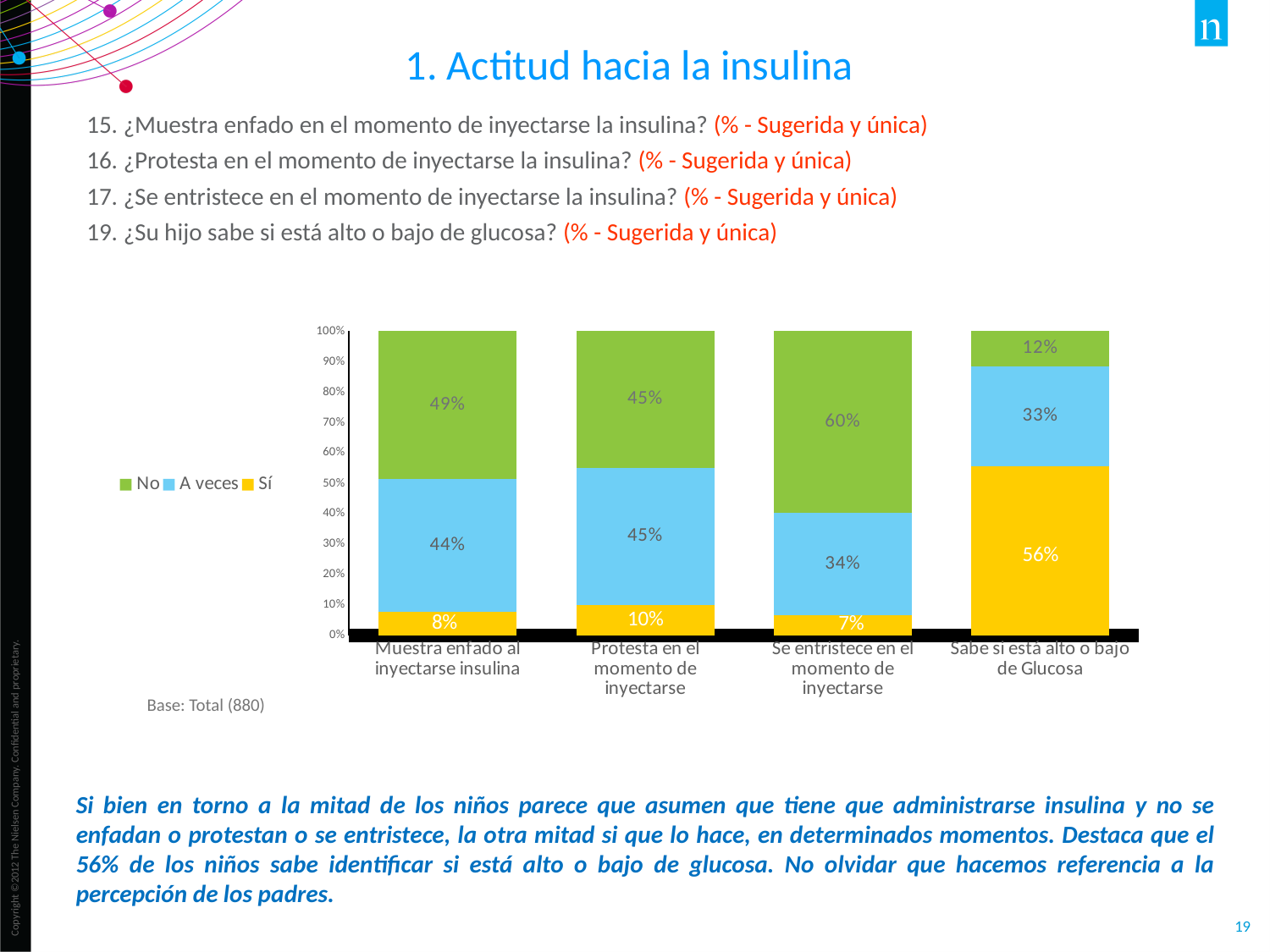
Which is larger: the "A veces" value for "Protesta en el momento de inyectarse" or the "A veces" value for "Se entristece en el momento de inyectarse"? Protesta en el momento de inyectarse What is the value of "Sí" for "Protesta en el momento de inyectarse"? 10% What is the value of "No" for "Se entristece en el momento de inyectarse"? 60% How many categories are shown on the x axis of the chart? 4 Which category has the lowest value for "No"? Sabe si está alto o bajo de Glucosa What kind of chart is shown on the slide? Stacked bar chart Which series is shown in yellow in the chart legend? Sí How many series does the chart legend list? 3 Which category has the highest value for "Sí"? Sabe si está alto o bajo de Glucosa What is the difference between the "No" value for "Se entristece en el momento de inyectarse" and the "No" value for "Muestra enfado al inyectarse insulina"? 11% What is the value of "A veces" for "Muestra enfado al inyectarse insulina"? 44% What is the value of "Sí" for "Sabe si está alto o bajo de Glucosa"? 56%